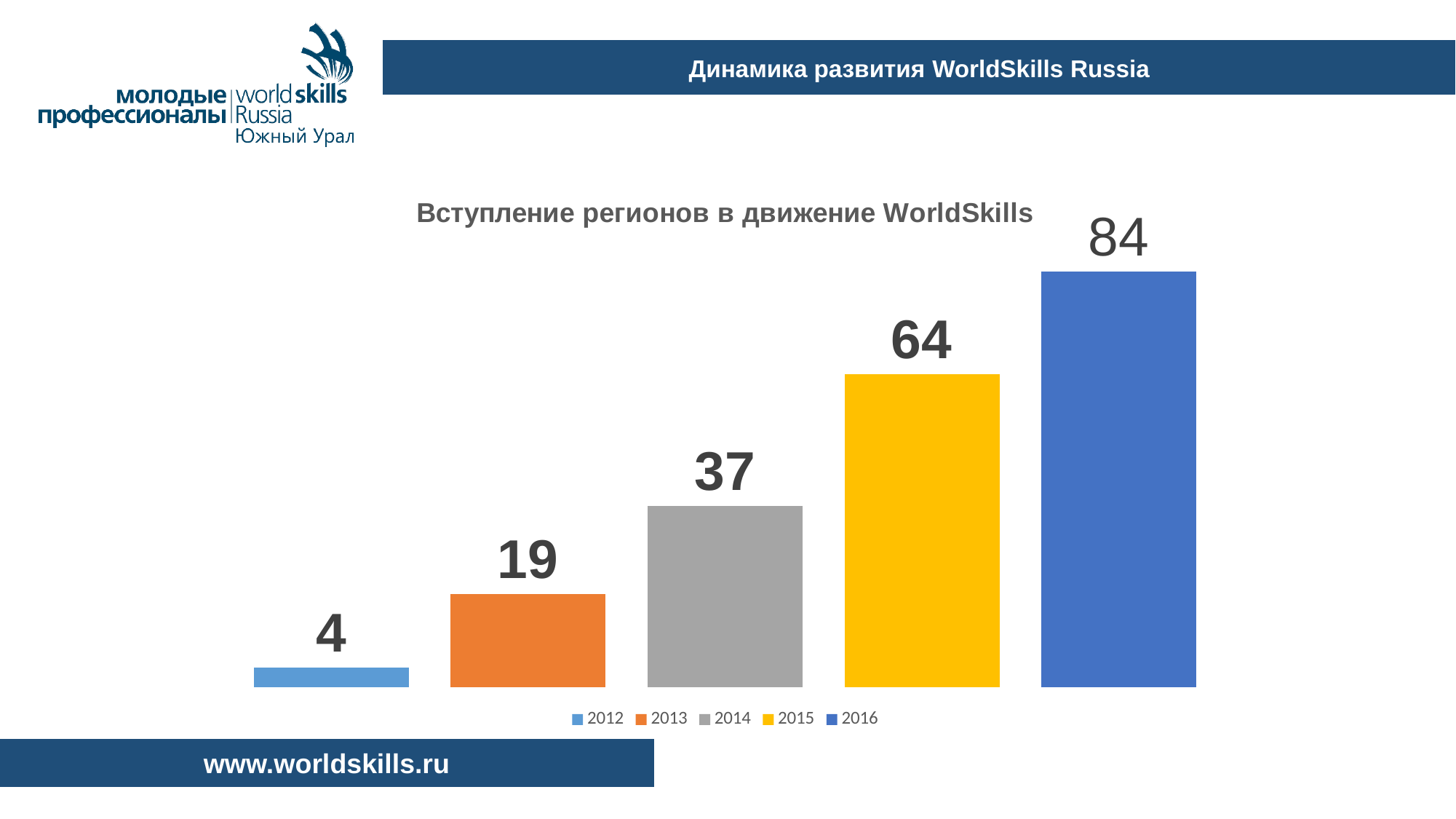
Do the values rise or fall from 2012 to 2016? Rise Which year has the lowest value? 2012 What is the value for 2014? 37 What is the difference between the values for 2014 and 2013? 18 What kind of chart is shown on the slide? Bar chart How many entries does the legend list? 5 What is the difference between the values for 2016 and 2015? 20 What is the value for 2016? 84 How many bars are shown in the chart? 5 Which is larger, the value for 2013 or the value for 2015? 2015 Which year has the highest value? 2016 What is the value for 2012? 4